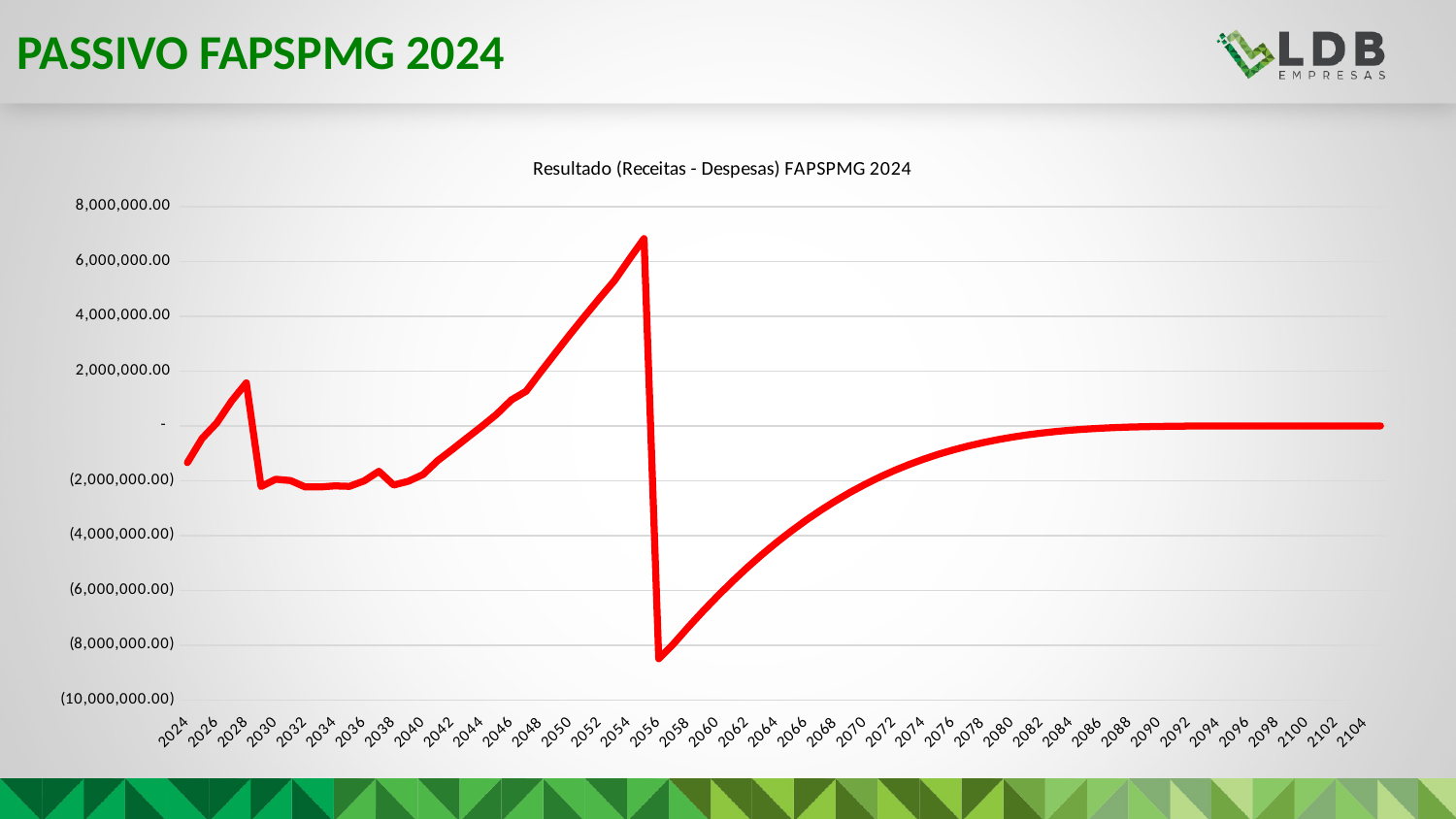
Is the highest point of the line greater or less than 6,000,000.00? greater Is the value for 2048 greater or less than 0 (shown as '-' on the axis)? greater What is the title of the chart? Resultado (Receitas - Despesas) FAPSPMG 2024 Is the value for 2028 greater or less than 0 (shown as '-' on the axis)? greater What colour is the line in the chart? red Does the line rise or fall between 2058 and 2080? rise Does the line rise or fall between 2040 and 2054? rise Does the line rise or fall between 2028 and 2030? fall What kind of chart is shown on the slide? line chart